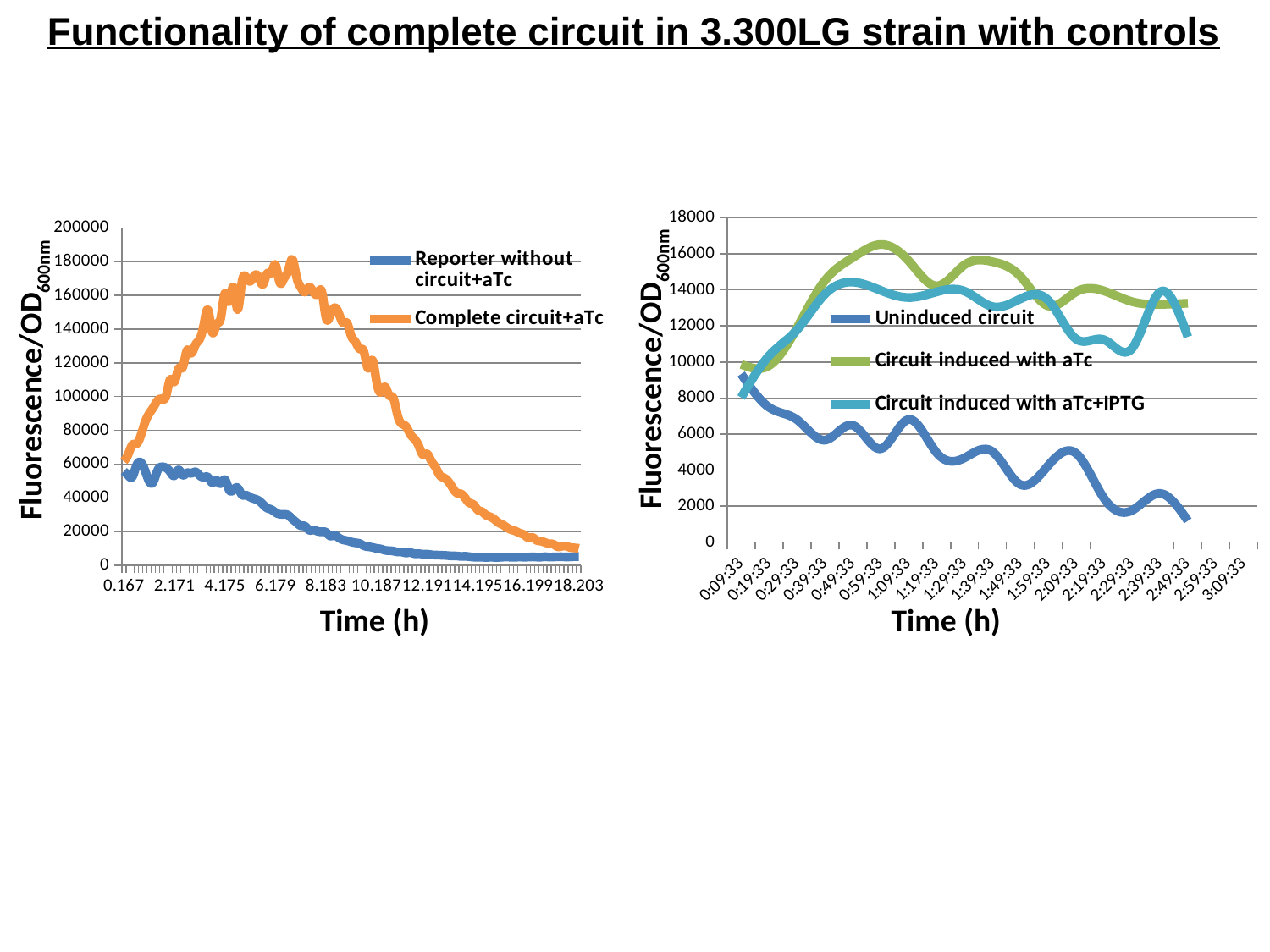
In the right chart, which series has the higher value at 0:59:33, Uninduced circuit or Circuit induced with aTc? Circuit induced with aTc In the left chart, which series reaches the higher peak value, Reporter without circuit+aTc or Complete circuit+aTc? Complete circuit+aTc In the right chart, is the peak value of Circuit induced with aTc greater or less than 14000? greater In the left chart, does the Reporter without circuit+aTc series rise or fall over time? fall In the right chart, is the final value of Uninduced circuit greater or less than 4000? less What kind of chart is the left chart? line chart In the left chart, is the peak value of Complete circuit+aTc greater or less than 160000? greater What is the title of the slide containing the two charts? Functionality of complete circuit in 3.300LG strain with controls How many series does the legend of the left chart list? 2 In the right chart, does the Uninduced circuit series rise or fall over time? fall How many series does the legend of the right chart list? 3